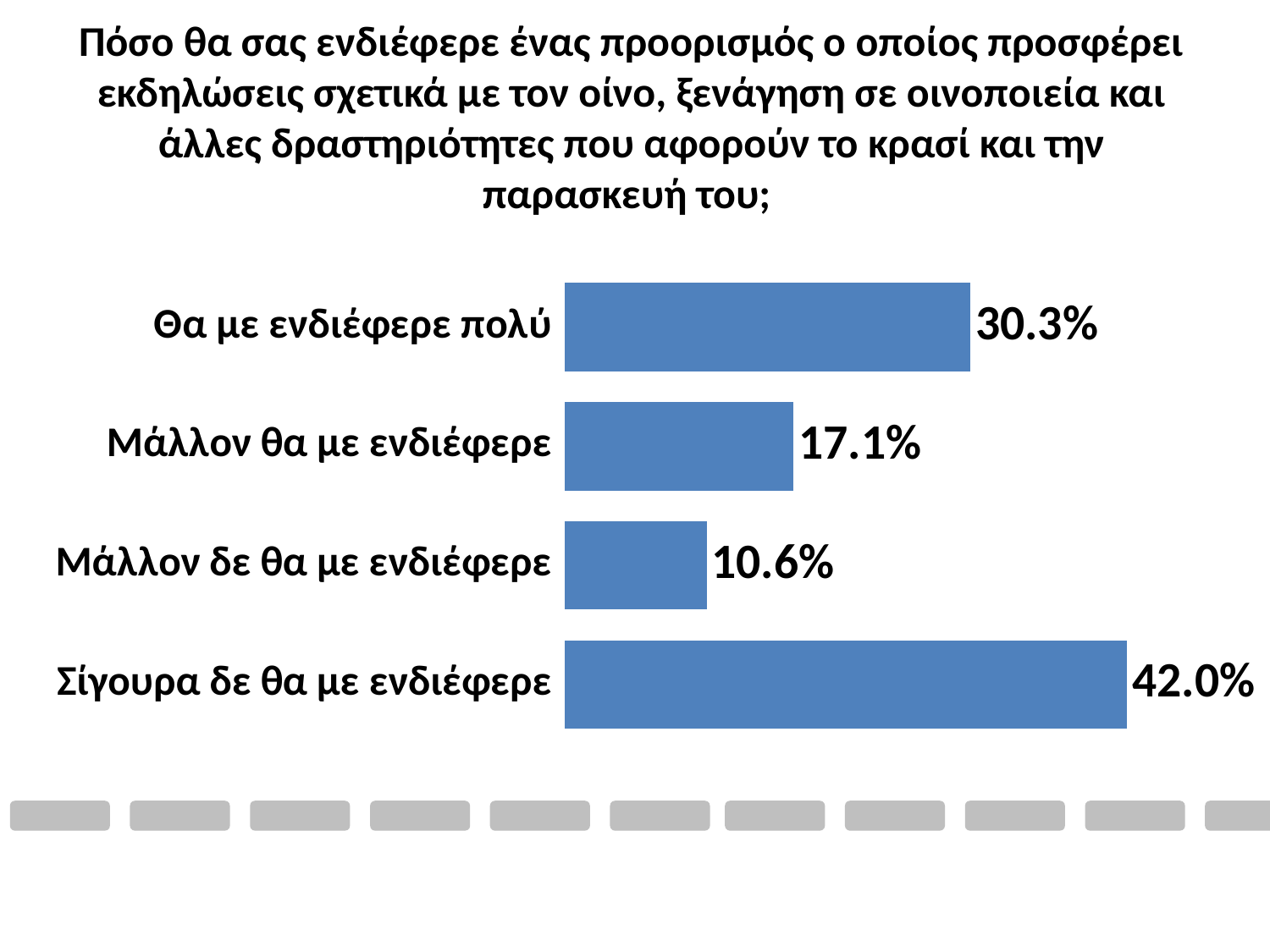
What is the value for "Σίγουρα δε θα με ενδιέφερε"? 42.0% What is the value for "Θα με ενδιέφερε πολύ"? 30.3% How many categories are shown in the chart? 4 What is the value for "Μάλλον δε θα με ενδιέφερε"? 10.6% Which category has the highest value? Σίγουρα δε θα με ενδιέφερε What is the difference between the values for "Μάλλον θα με ενδιέφερε" and "Μάλλον δε θα με ενδιέφερε"? 6.5% What is the difference between the values for "Σίγουρα δε θα με ενδιέφερε" and "Θα με ενδιέφερε πολύ"? 11.7% Which category has the lowest value? Μάλλον δε θα με ενδιέφερε What is the value for "Μάλλον θα με ενδιέφερε"? 17.1% What kind of chart is shown on the slide? Bar chart Which is larger, the value for "Θα με ενδιέφερε πολύ" or the value for "Μάλλον θα με ενδιέφερε"? Θα με ενδιέφερε πολύ What colour are the bars in the chart? Blue